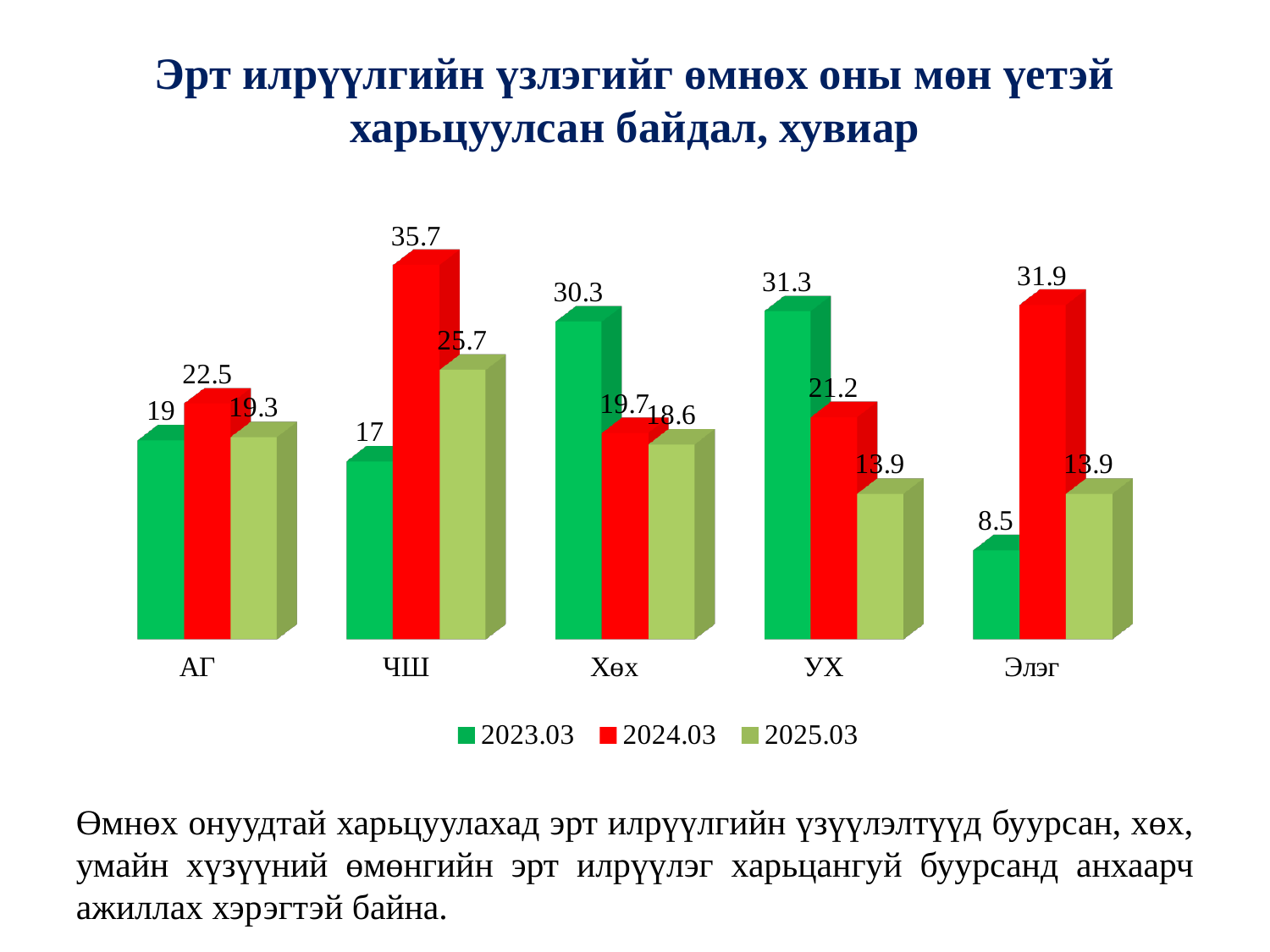
What kind of chart is shown on the slide? bar chart Which category has the highest value in the 2024.03 series? ЧШ How many series does the legend list? 3 What is the value for ЧШ in the 2024.03 series? 35.7 What is the difference between the 2024.03 and 2023.03 values for Элэг? 23.4 What colour are the bars for the 2024.03 series? red Which is larger for УХ: the 2023.03 value or the 2024.03 value? 2023.03 What is the value for Элэг in the 2023.03 series? 8.5 Which category has the highest value in the 2025.03 series? ЧШ What is the value for Хөх in the 2025.03 series? 18.6 Which category has the lowest value in the 2023.03 series? Элэг How many categories are shown on the x axis? 5